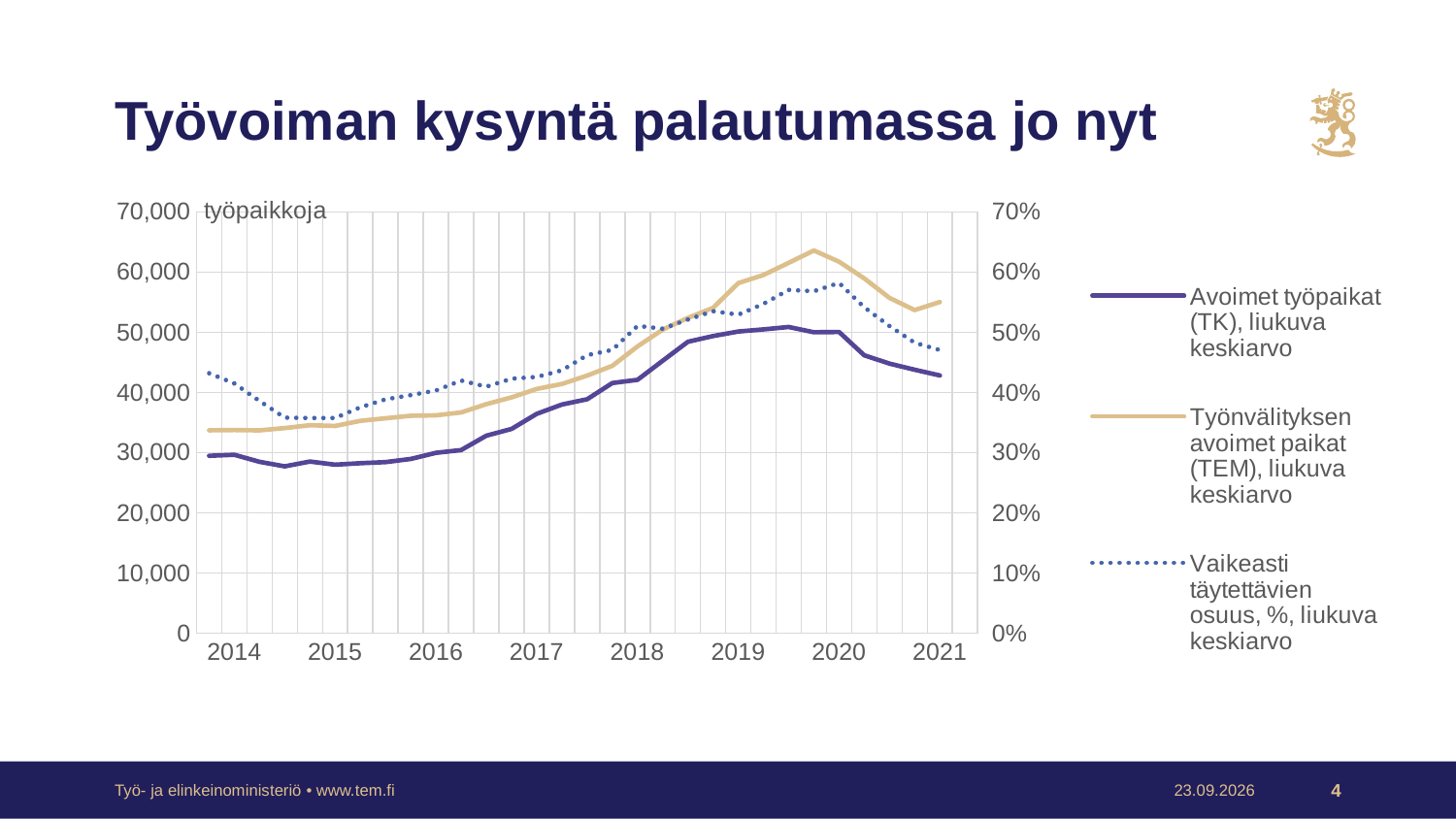
Is the value of 'Vaikeasti täytettävien osuus, %, liukuva keskiarvo' in 2015 greater or less than 40%? less How many year labels are shown on the x axis? 8 At 2021, which series is higher: 'Työnvälityksen avoimet paikat (TEM), liukuva keskiarvo' or 'Avoimet työpaikat (TK), liukuva keskiarvo'? Työnvälityksen avoimet paikat (TEM), liukuva keskiarvo Is the value of 'Avoimet työpaikat (TK), liukuva keskiarvo' in 2015 greater or less than 30,000? less Is the value of 'Työnvälityksen avoimet paikat (TEM), liukuva keskiarvo' at its 2020 peak greater or less than 60,000? greater How many series does the legend list? 3 Does 'Avoimet työpaikat (TK), liukuva keskiarvo' rise or fall between 2015 and 2019? rise What is the title of the slide's chart? Työvoiman kysyntä palautumassa jo nyt What kind of chart is shown on the slide? line chart Which series is drawn with a dotted line? Vaikeasti täytettävien osuus, %, liukuva keskiarvo